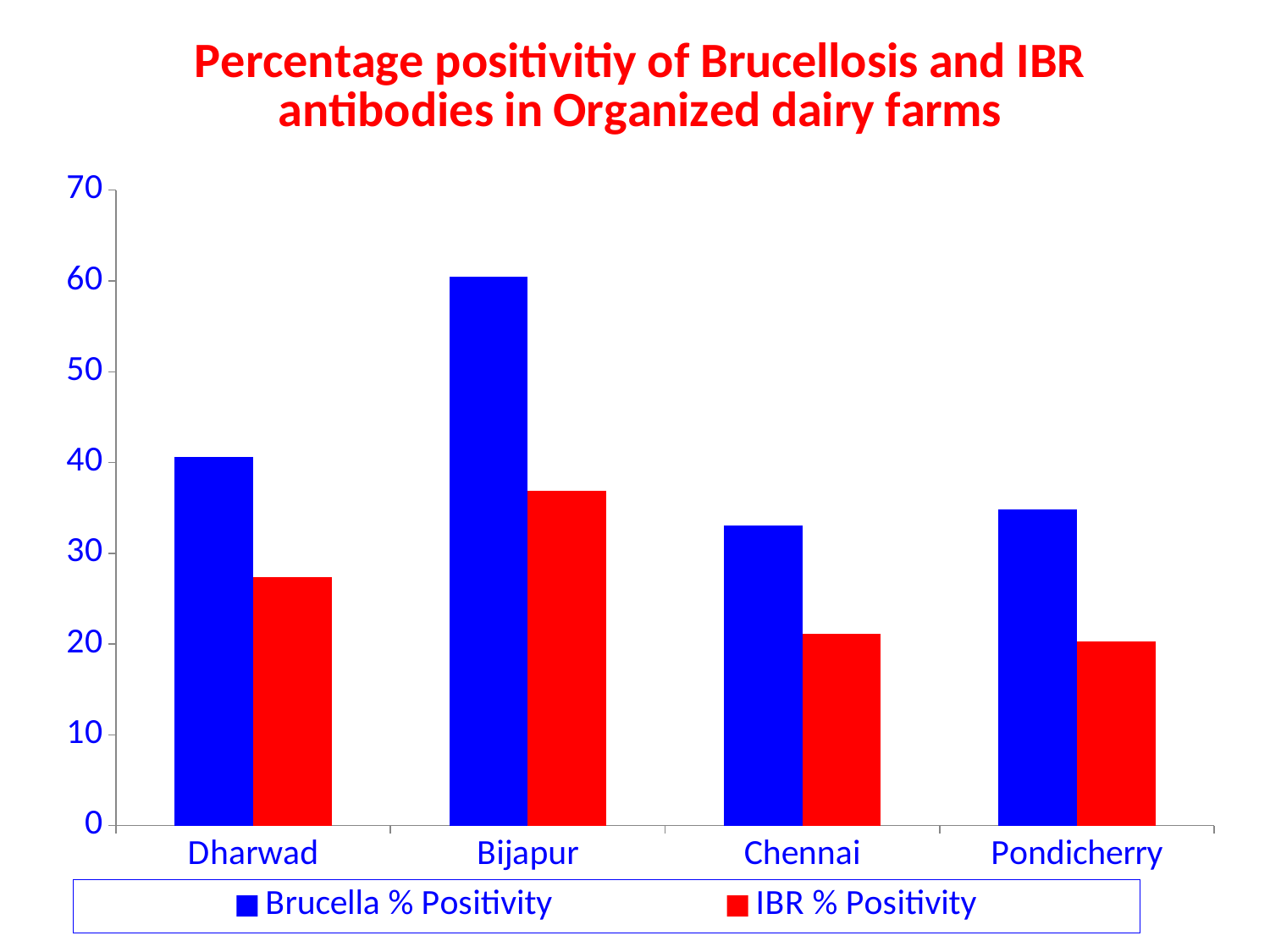
Is the IBR % Positivity for Bijapur greater or less than 30? greater What colour are the bars for IBR % Positivity? red Is the Brucella % Positivity for Pondicherry greater or less than 30? greater Is the Brucella % Positivity for Bijapur greater or less than 50? greater Which is larger, the IBR % Positivity for Dharwad or for Chennai? Dharwad How many series does the legend list? 2 Which location has the highest IBR % Positivity? Bijapur In Chennai, which series has the larger value, Brucella % Positivity or IBR % Positivity? Brucella % Positivity Which location has the highest Brucella % Positivity? Bijapur What kind of chart is shown on the slide? bar chart How many locations are shown on the x axis? 4